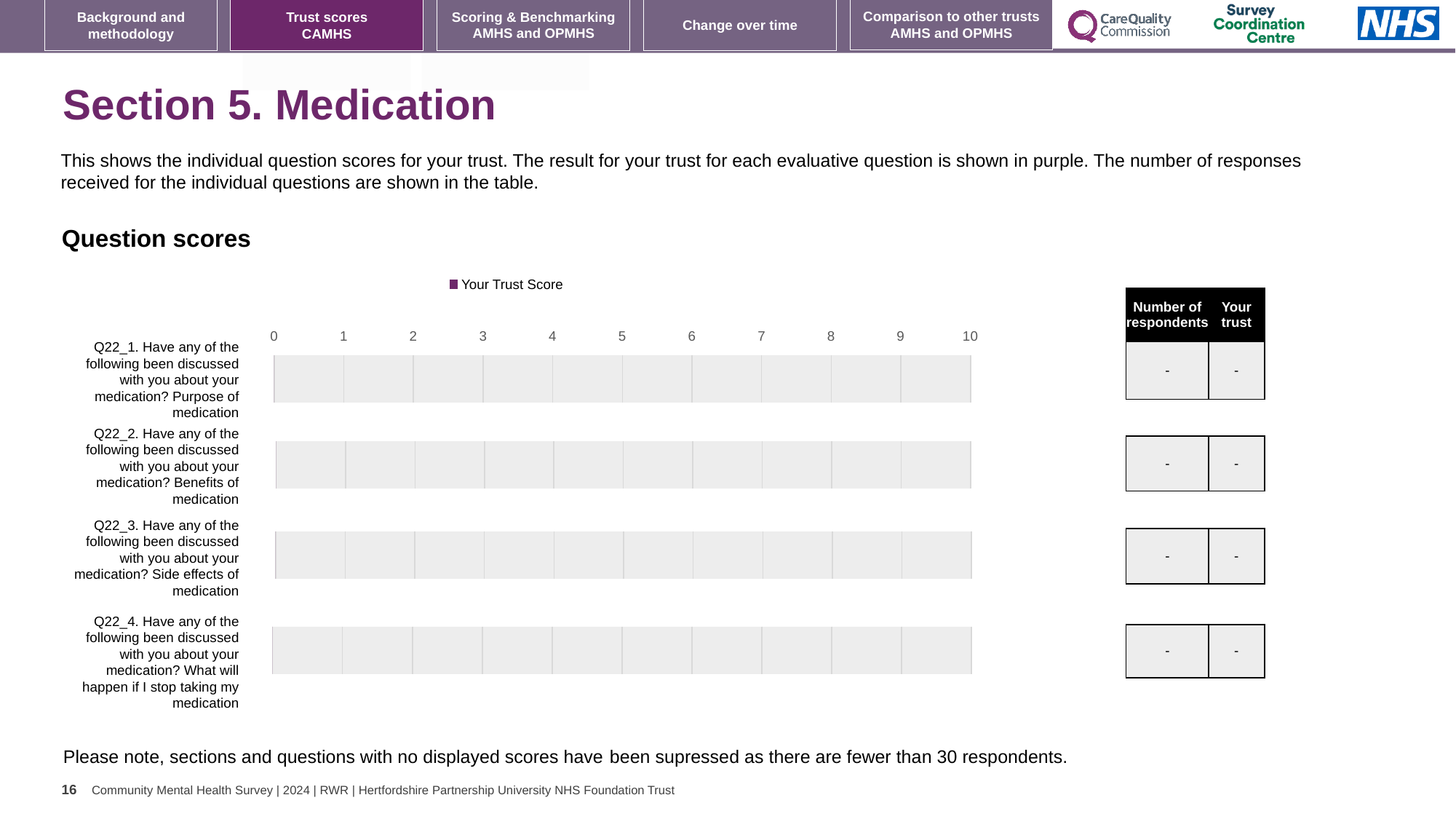
What is shown in the 'Number of respondents' column of the table for Q22_3? - What is shown in the 'Your trust' column of the table for Q22_1? - How many series does the chart legend list? 1 What is the name of the series shown in the chart legend? Your Trust Score What is shown in the 'Your trust' column of the table for Q22_4? - How many questions (categories) are listed on the chart's vertical axis? 4 What is the maximum value shown on the chart's horizontal axis? 10 Which question label on the chart refers to side effects of medication? Q22_3 What kind of chart is shown under the heading 'Question scores'? bar chart Are any trust scores plotted as bars on the chart? No